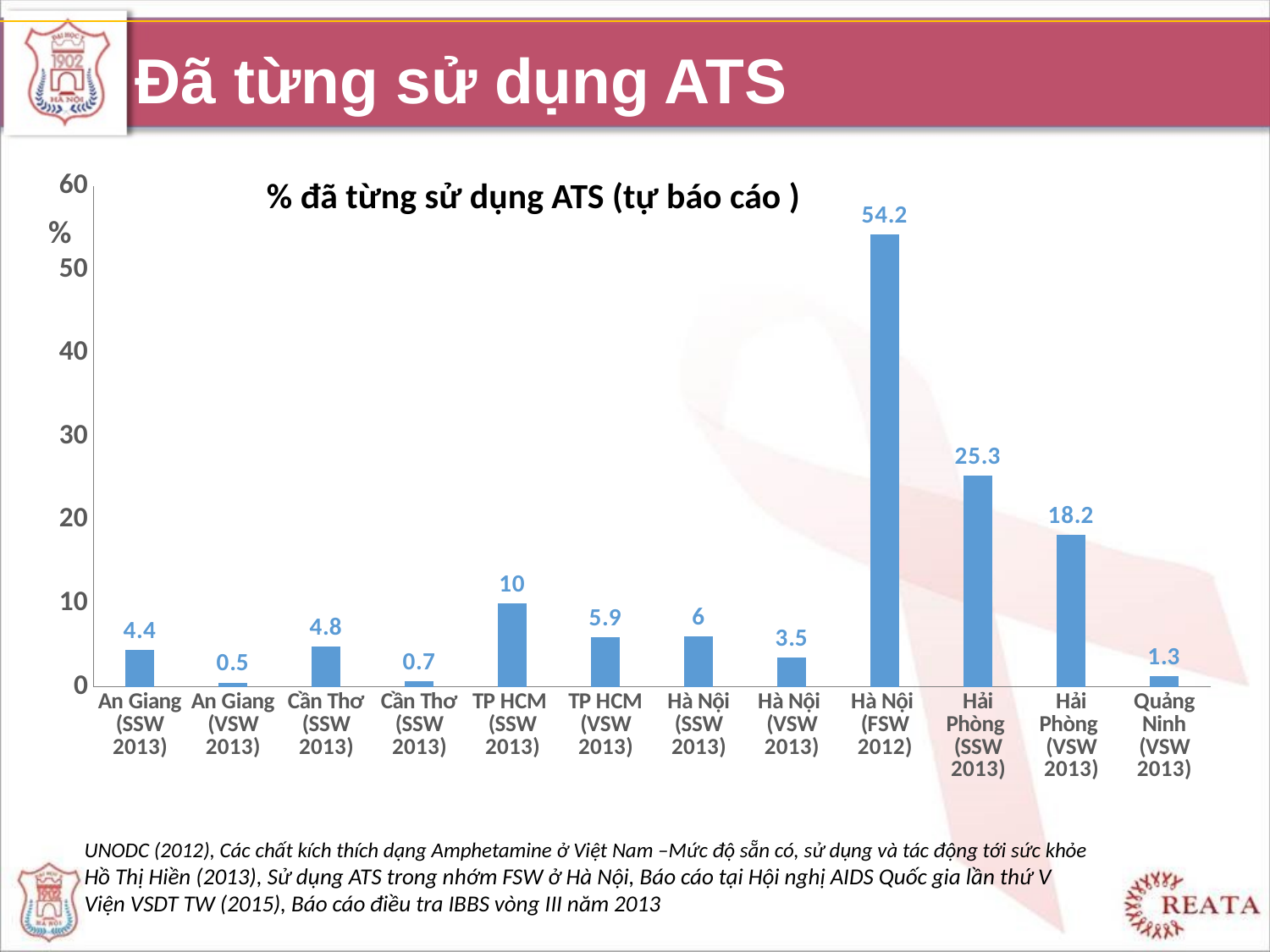
What is the value for Quảng Ninh (VSW 2013)? 1.3 What kind of chart is shown? bar chart What is the title of the chart? % đã từng sử dụng ATS (tự báo cáo ) Which is larger, TP HCM (SSW 2013) or Hà Nội (SSW 2013)? TP HCM (SSW 2013) What is the value for Hải Phòng (SSW 2013)? 25.3 What is the value for Hà Nội (FSW 2012)? 54.2 What is the difference between Hải Phòng (SSW 2013) and Hải Phòng (VSW 2013)? 7.1 Is the value for Hải Phòng (VSW 2013) greater or less than 20? less Which category has the highest value? Hà Nội (FSW 2012) Which category has the lowest value? An Giang (VSW 2013) How many categories are shown on the x axis? 12 What is the value for TP HCM (VSW 2013)? 5.9